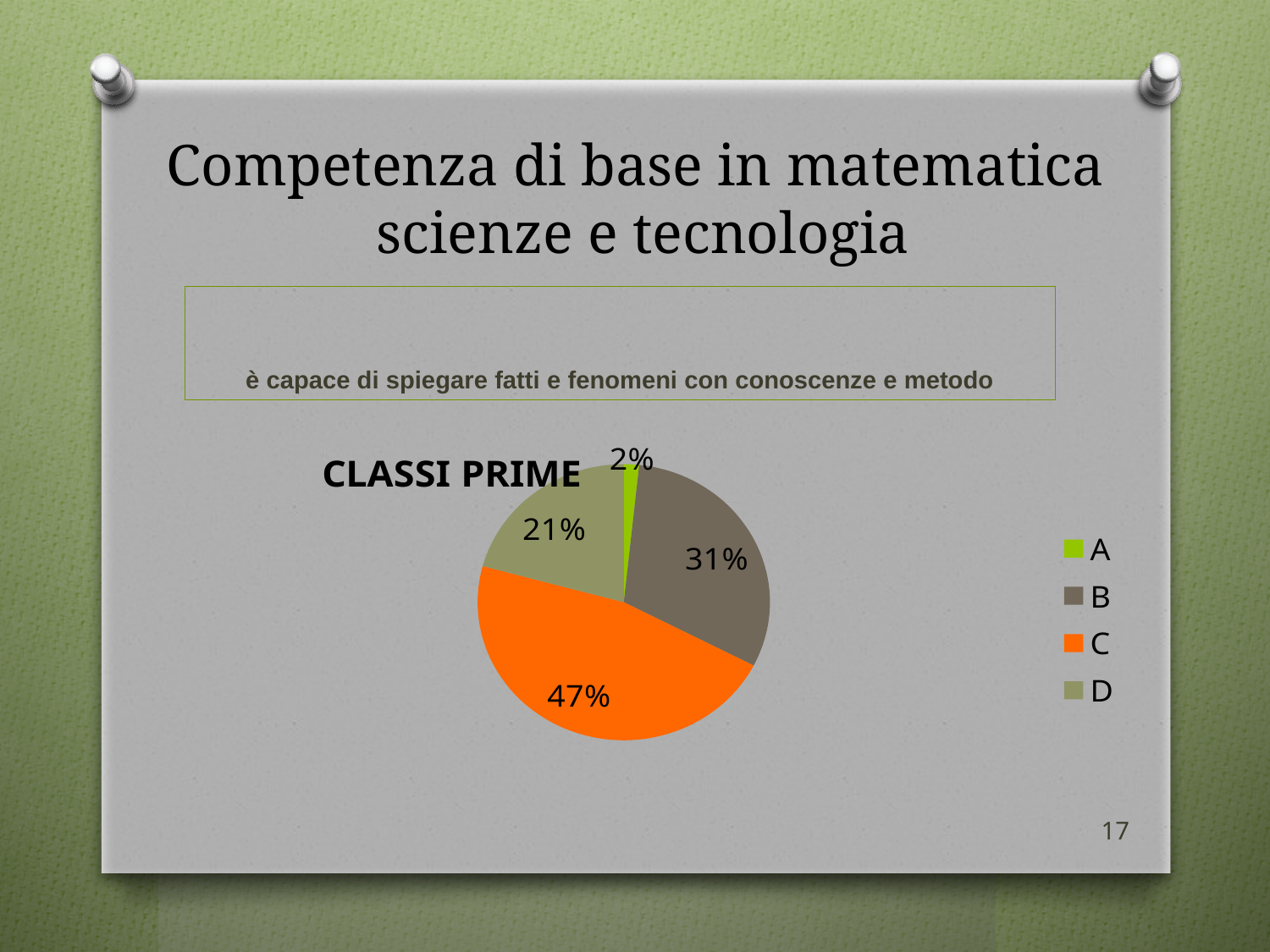
How many categories does the legend list? 4 What kind of chart is shown on the slide? pie chart What percentage of the pie does category A represent? 2% What colour is the slice for category C? orange What percentage of the pie does category B represent? 31% Which category has the smallest slice of the pie? A Which category has the largest slice of the pie? C What percentage of the pie does category C represent? 47% Which is larger, the slice for B or the slice for D? B What is the title of the pie chart? CLASSI PRIME What percentage of the pie does category D represent? 21% What is the difference in percentage points between category C and category B? 16